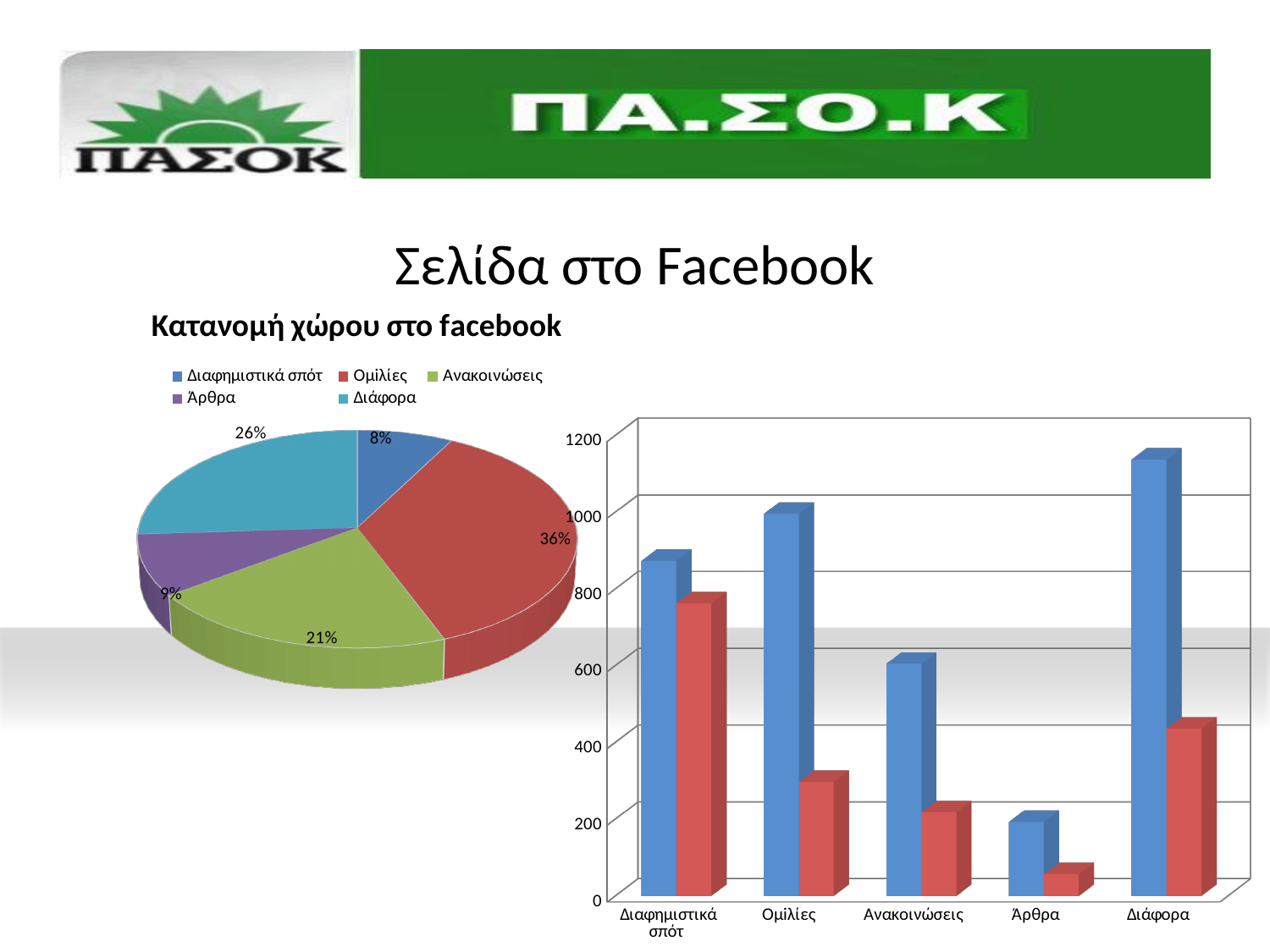
In the bar chart on the right, is the blue bar for Ομιλίες larger or smaller than the blue bar for Ανακοινώσεις? larger In the pie chart 'Κατανομή χώρου στο facebook', what percentage is shown for Διάφορα? 26% In the bar chart on the right, is the blue bar for Διάφορα greater or less than 1000? greater In the pie chart 'Κατανομή χώρου στο facebook', how many categories does the legend list? 5 In the pie chart 'Κατανομή χώρου στο facebook', what percentage is shown for Άρθρα? 9% In the pie chart 'Κατανομή χώρου στο facebook', which category has the largest share? Ομιλίες In the bar chart on the right, which category has the lowest blue bar? Άρθρα In the pie chart 'Κατανομή χώρου στο facebook', what percentage is shown for Ομιλίες? 36% In the pie chart 'Κατανομή χώρου στο facebook', how many percentage points larger is Ομιλίες than Ανακοινώσεις? 15 What kind of chart is the chart on the right side of the slide? Bar chart In the pie chart 'Κατανομή χώρου στο facebook', which category has the smallest share? Διαφημιστικά σπότ In the bar chart on the right, is the red bar for Ομιλίες greater or less than 400? less